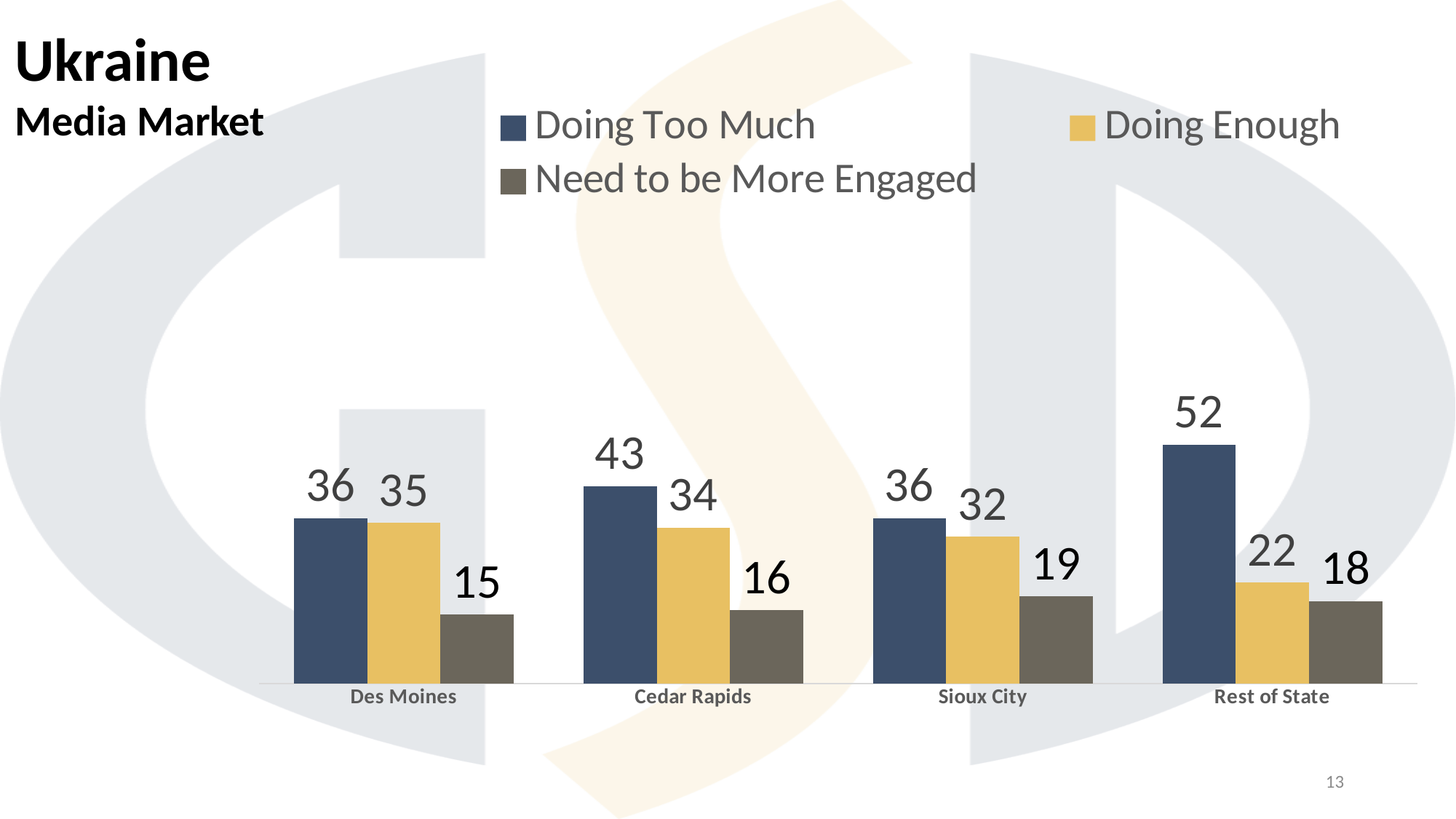
How many series does the legend list? 3 Which media market has the highest value for Doing Too Much? Rest of State Which is larger in Cedar Rapids: Doing Too Much or Doing Enough? Doing Too Much What is the value for Doing Enough in Cedar Rapids? 34 Which media market has the lowest value for Need to be More Engaged? Des Moines Which media market has the lowest value for Doing Enough? Rest of State What kind of chart is shown on the slide? Bar chart What is the difference between Doing Too Much and Doing Enough in Rest of State? 30 What is the value for Need to be More Engaged in Sioux City? 19 What is the value for Doing Too Much in Rest of State? 52 What colour are the Doing Enough bars? Yellow How many media markets are shown on the x axis? 4